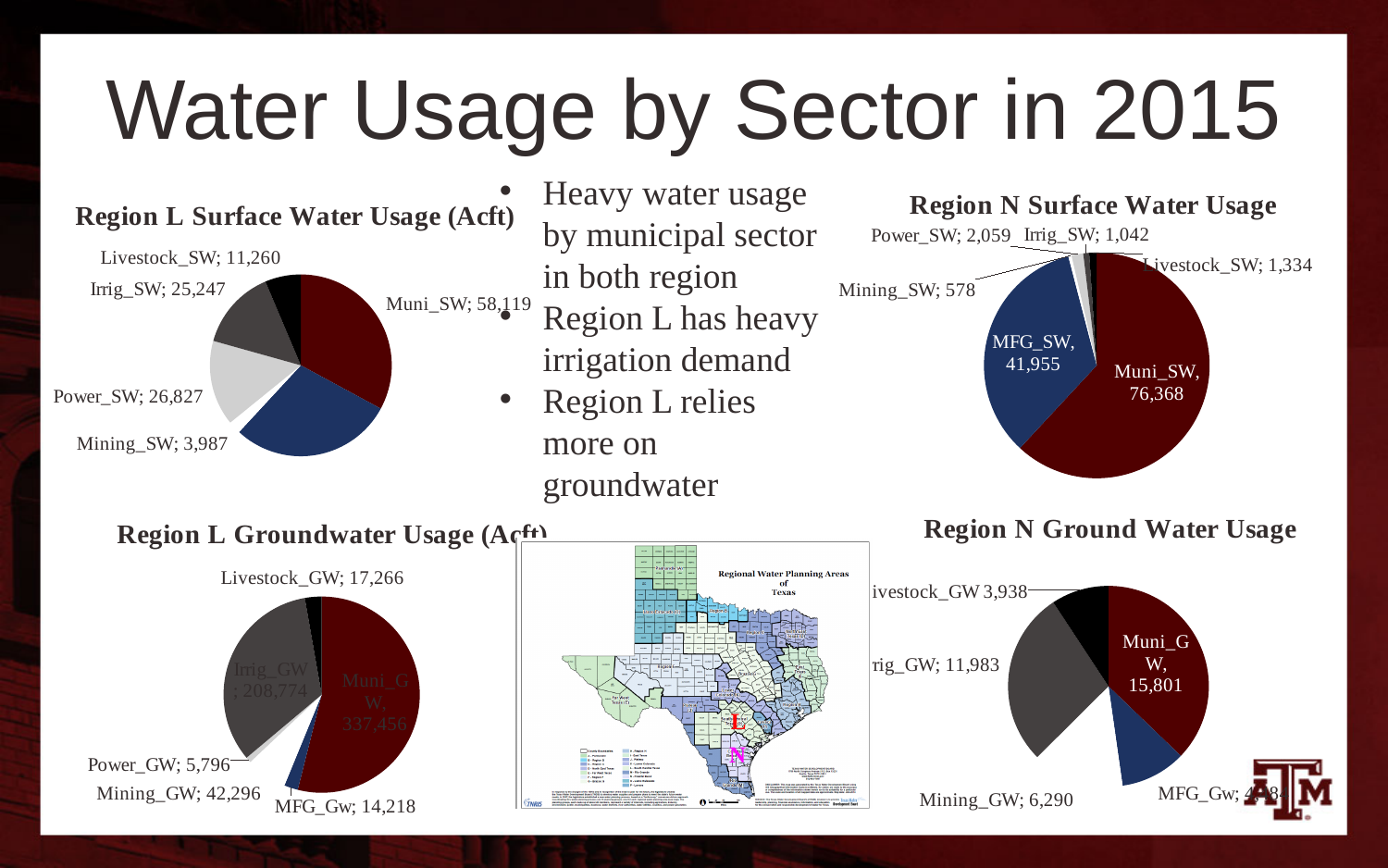
In the Region N Surface Water Usage chart, what is the value for Muni_SW? 76,368 In the Region N Surface Water Usage chart, what is the difference between Muni_SW and MFG_SW? 34,413 What type of chart is the Region N Ground Water Usage chart? Pie chart In the Region L Surface Water Usage (Acft) chart, what is the value for Mining_SW? 3,987 In the Region L Groundwater Usage (Acft) chart, what is the value for Irrig_GW? 208,774 In the Region L Surface Water Usage (Acft) chart, what is the difference between Power_SW and Irrig_SW? 1,580 In the Region L Surface Water Usage (Acft) chart, what is the value for Muni_SW? 58,119 In the Region N Surface Water Usage chart, which sector has the lowest value? Mining_SW How many sectors are shown in the Region N Surface Water Usage chart? 6 In the Region L Groundwater Usage (Acft) chart, what is the value for Muni_GW? 337,456 In the Region L Groundwater Usage (Acft) chart, which is larger, Mining_GW or MFG_Gw? Mining_GW In the Region L Groundwater Usage (Acft) chart, which sector has the highest value? Muni_GW